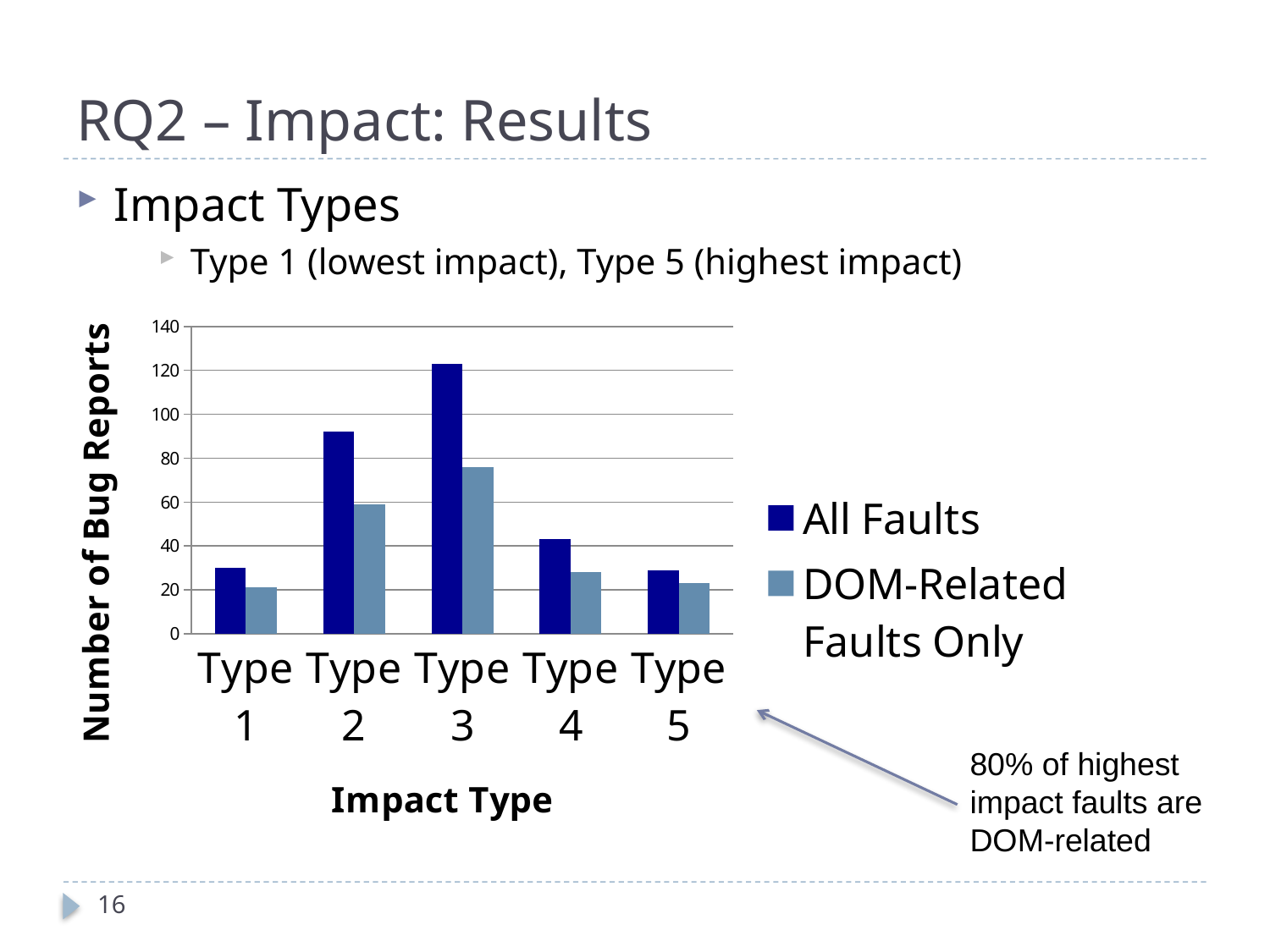
What kind of chart is shown on the slide? bar chart Do the All Faults values rise or fall from Type 3 to Type 5? fall Which impact type has the highest number of bug reports for All Faults? Type 3 Which is larger for All Faults: Type 2 or Type 4? Type 2 How many impact type categories are shown on the x axis? 5 What is the title of the y axis? Number of Bug Reports How many series does the legend list? 2 Is the All Faults value for Type 3 greater or less than 100? greater Which impact type has the highest number of bug reports for DOM-Related Faults Only? Type 3 Is the All Faults value for Type 1 greater or less than 40? less Is the DOM-Related Faults Only value for Type 3 greater or less than 60? greater